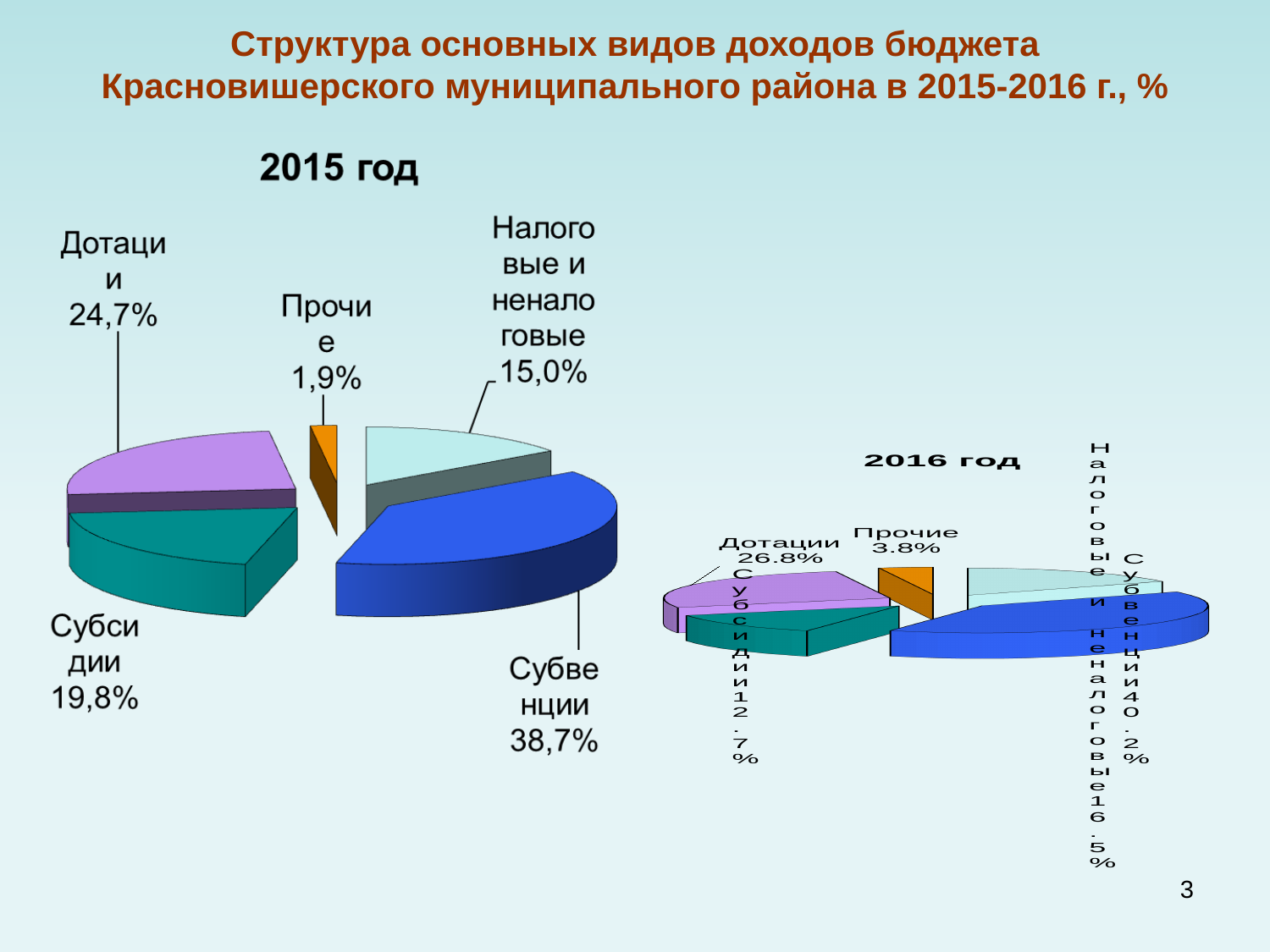
On the 2015 год chart, what share do Субвенции have? 38,7% On the 2015 год chart, which is larger: Дотации or Налоговые и неналоговые? Дотации On the 2016 год chart, what share do Прочие have? 3.8% On the 2015 год chart, what share do Дотации have? 24,7% On the 2015 год chart, what share do Субсидии have? 19,8% On the 2016 год chart, what share do Дотации have? 26.8% On the 2015 год chart, which category has the largest share? Субвенции On the 2015 год chart, what is the difference between the shares of Дотации and Субсидии? 4,9% What type of chart is the 2015 год chart? Pie chart On the 2015 год chart, what share do Налоговые и неналоговые have? 15,0% How many categories does the 2015 год chart show? 5 On the 2015 год chart, which category has the smallest share? Прочие